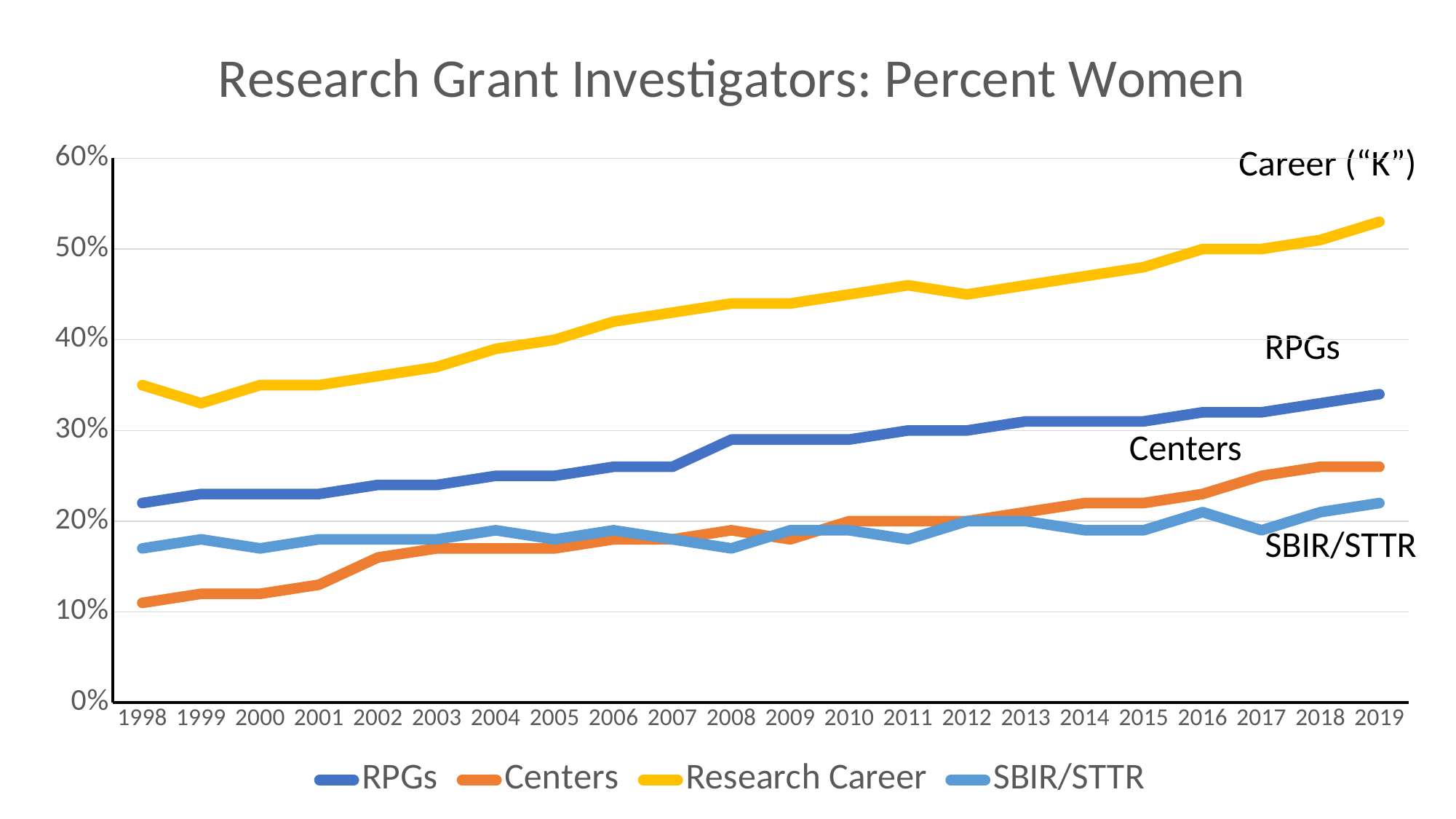
Is the value for RPGs in 2019 greater or less than 30%? greater What kind of chart is shown on the slide? line chart How many series does the legend list? 4 What is the title of the chart? Research Grant Investigators: Percent Women Is the value for Centers in 1998 greater or less than 20%? less Is the value for Research Career in 2019 greater or less than 50%? greater In 2019, which is larger: the value for RPGs or the value for Centers? RPGs Does the Research Career series generally rise or fall from 1998 to 2019? rise Which series has the lowest value in 1998? Centers Which series has the highest value in 2019? Research Career How many years are shown along the x axis? 22